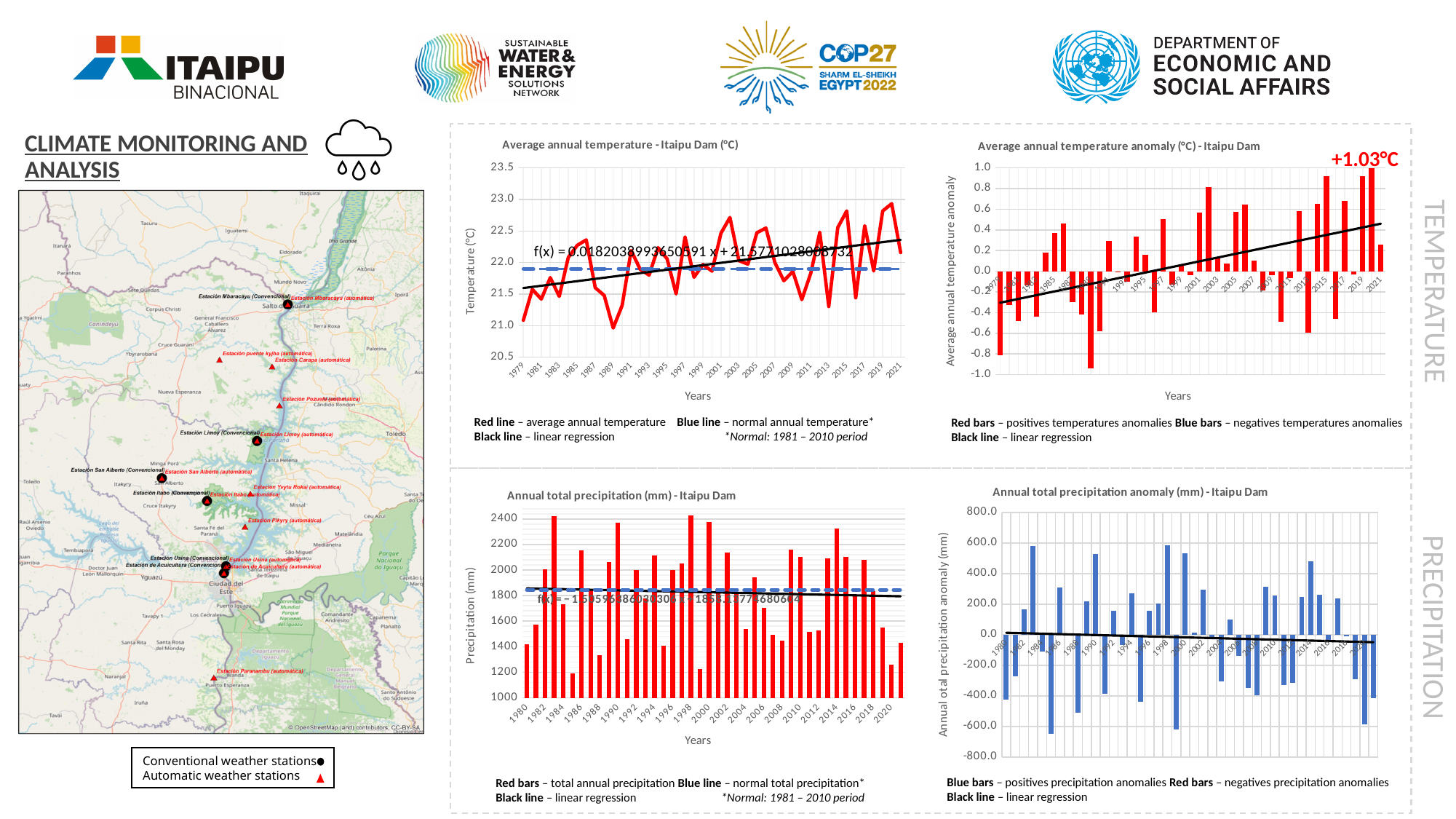
What kind of chart is the 'Annual total precipitation (mm) - Itaipu Dam' chart? bar chart In the 'Average annual temperature - Itaipu Dam (°C)' chart, is the value for 2020 greater or less than 22.5? greater What kind of chart is the 'Average annual temperature - Itaipu Dam (°C)' chart? line chart In the 'Annual total precipitation anomaly (mm) - Itaipu Dam' chart, does the black linear regression line rise or fall from 1980 to 2021? fall In the 'Annual total precipitation (mm) - Itaipu Dam' chart, is the value for 2020 greater or less than 1400? less In the 'Average annual temperature - Itaipu Dam (°C)' chart, is the value for 1979 greater or less than 21.5? less What value is printed in red at the top right of the 'Average annual temperature anomaly (°C) - Itaipu Dam' chart? +1.03°C In the 'Average annual temperature - Itaipu Dam (°C)' chart, does the black linear regression line rise or fall from 1979 to 2021? rise